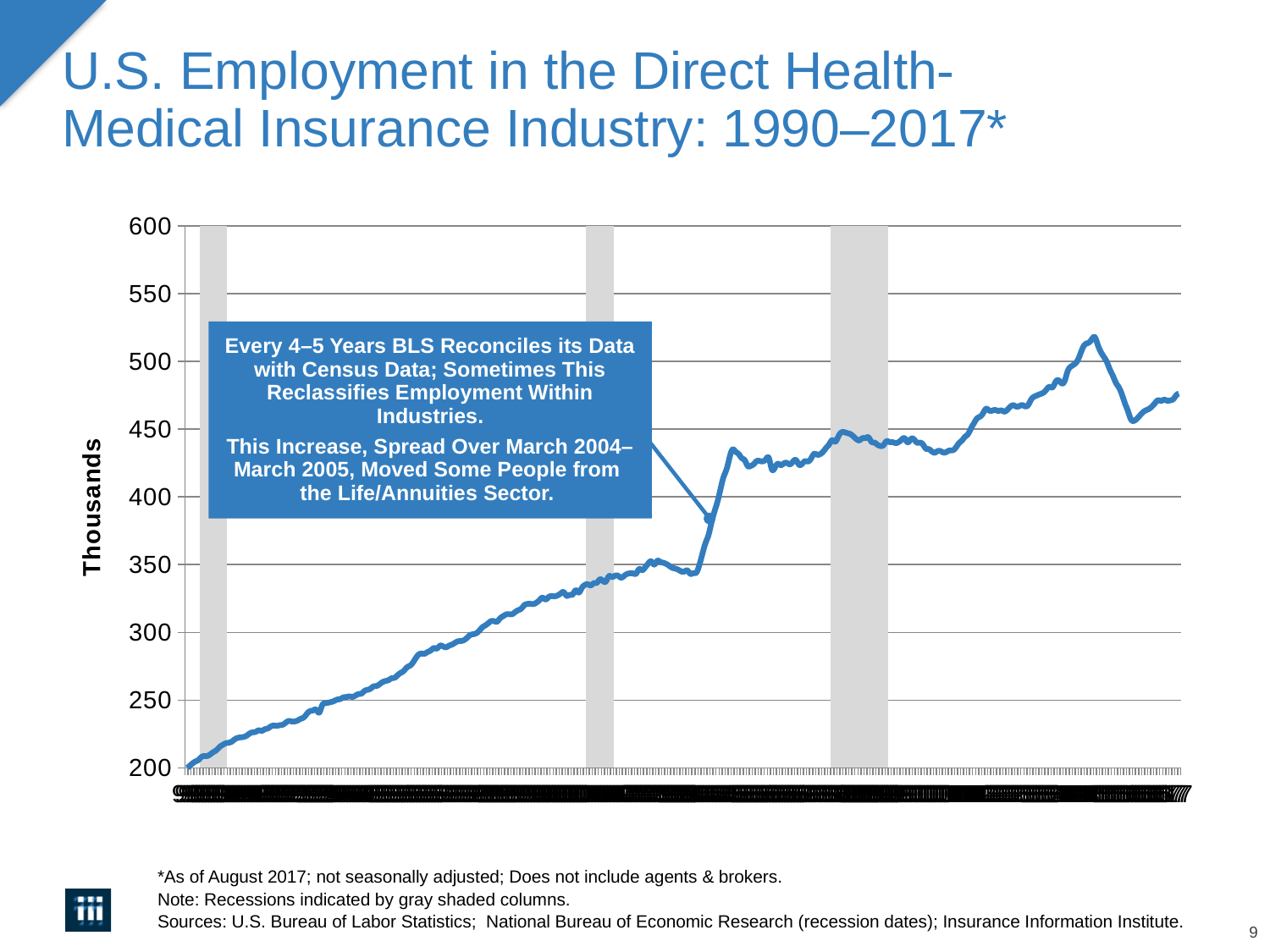
Is the employment value at the start of the series (1990) greater or less than 250? less Is the employment value at the end of the series (August 2017) greater or less than 450? greater Overall, do the employment values rise or fall from 1990 to 2017 along the x axis? rise What kind of chart is shown on the slide? line chart Is the highest point reached by the line greater or less than 500? greater What is the label on the vertical axis? Thousands How many gray shaded recession columns appear on the chart? 3